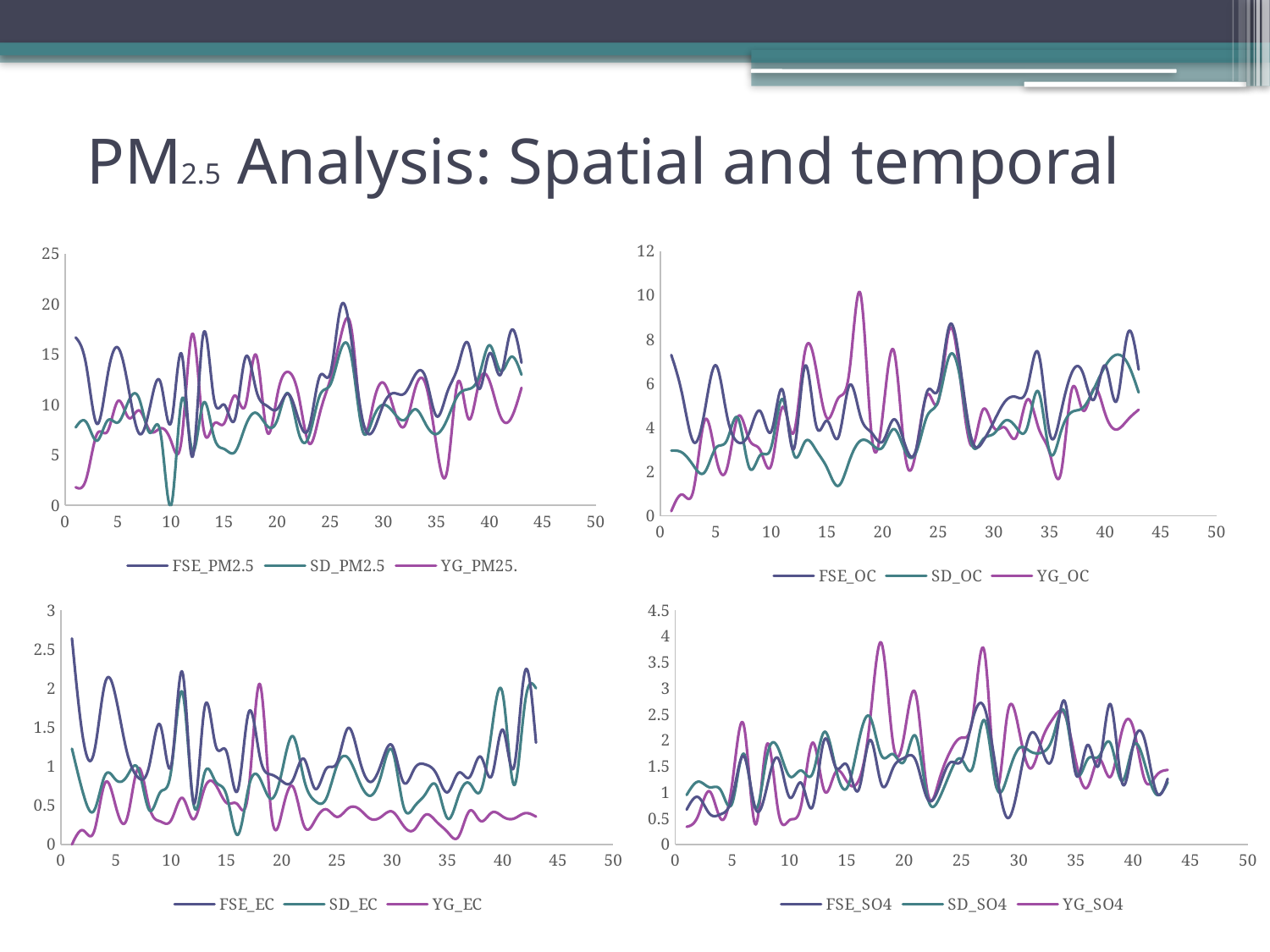
In the bottom-right chart, is the peak value of YG_SO4 greater or less than 3? greater What are the legend entries of the bottom-right chart? FSE_SO4, SD_SO4, YG_SO4 In the bottom-left chart, which series reaches the highest value? FSE_EC What kind of chart is the top-left chart (FSE_PM2.5, SD_PM2.5, YG_PM25.)? Line chart In the bottom-right chart, which series reaches the highest value? YG_SO4 In the bottom-left chart, is the peak value of YG_EC greater or less than 2.5? less How many series does the legend of the top-right chart (FSE_OC, SD_OC, YG_OC) list? 3 What is the maximum value shown on the y axis of the top-left chart? 25 In the top-right chart, is the peak value of YG_OC greater or less than 8? greater How many series does the legend of the bottom-left chart (FSE_EC, SD_EC, YG_EC) list? 3 In the top-right chart, which series reaches the highest value? YG_OC